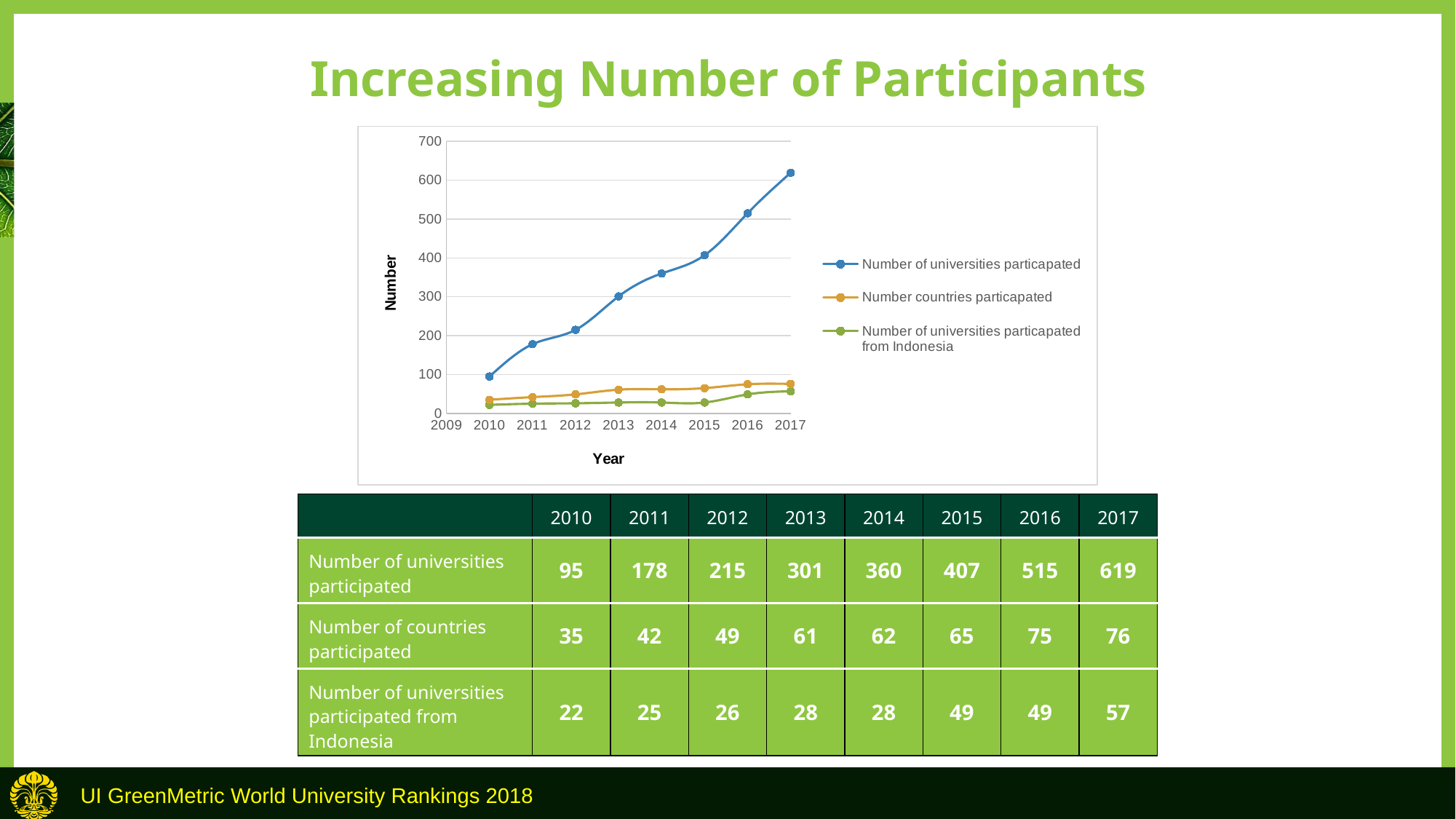
Is the number of universities participated in 2015 greater or less than 400? greater In which year is the number of universities participated from Indonesia lowest? 2010 In which year is the number of universities participated highest? 2017 What kind of chart is shown on the slide? line chart What is the number of countries participated in 2013? 61 What is the number of universities participated in 2017? 619 How many series does the chart legend list? 3 What is the difference between the number of universities participated in 2017 and in 2016? 104 Does the number of universities participated rise or fall from 2010 to 2017? rise Which is larger in 2014: the number of countries participated or the number of universities participated from Indonesia? Number of countries participated How many years are plotted for each series in the chart? 8